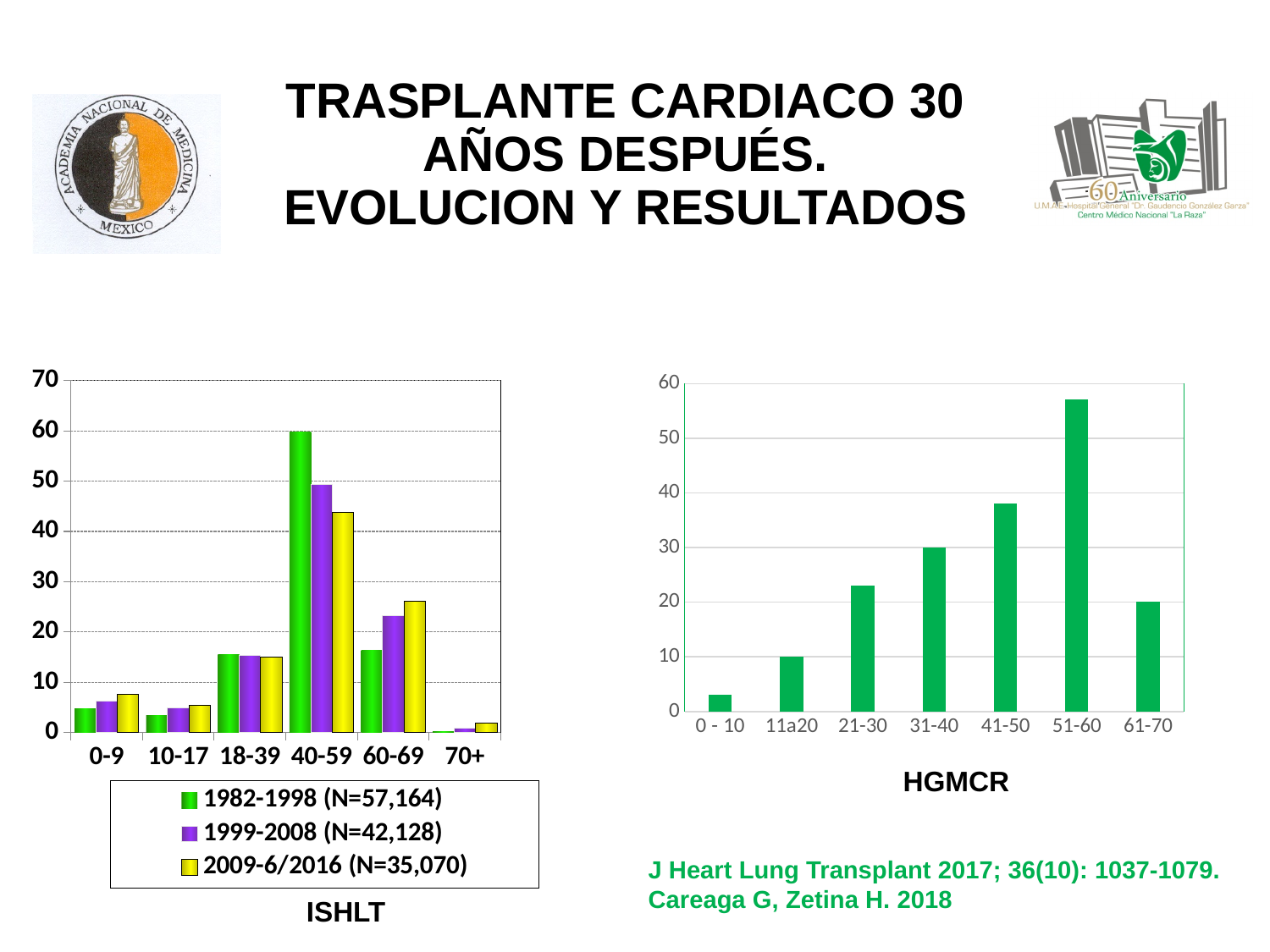
How many series does the legend of the ISHLT chart list? 3 In the ISHLT chart, for the 60-69 group, which series has the larger value: 1999-2008 or 2009-6/2016? 2009-6/2016 How many categories are shown on the x axis of the HGMCR chart? 7 In the HGMCR chart, which category has the lowest value? 0 - 10 According to the legend of the ISHLT chart, what is the N for the 1982-1998 series? N=57,164 What kind of chart is the ISHLT chart on the left of the slide? bar chart In the ISHLT chart, which age group has the highest value for the 1982-1998 series? 40-59 In the ISHLT chart, is the value for the 40-59 group in the 2009-6/2016 series greater or less than 40? greater In the HGMCR chart, which category has the highest value? 51-60 In the HGMCR chart, is the value for 51-60 greater or less than 50? greater What kind of chart is the HGMCR chart on the right of the slide? bar chart How many age-group categories are shown on the x axis of the ISHLT chart? 6